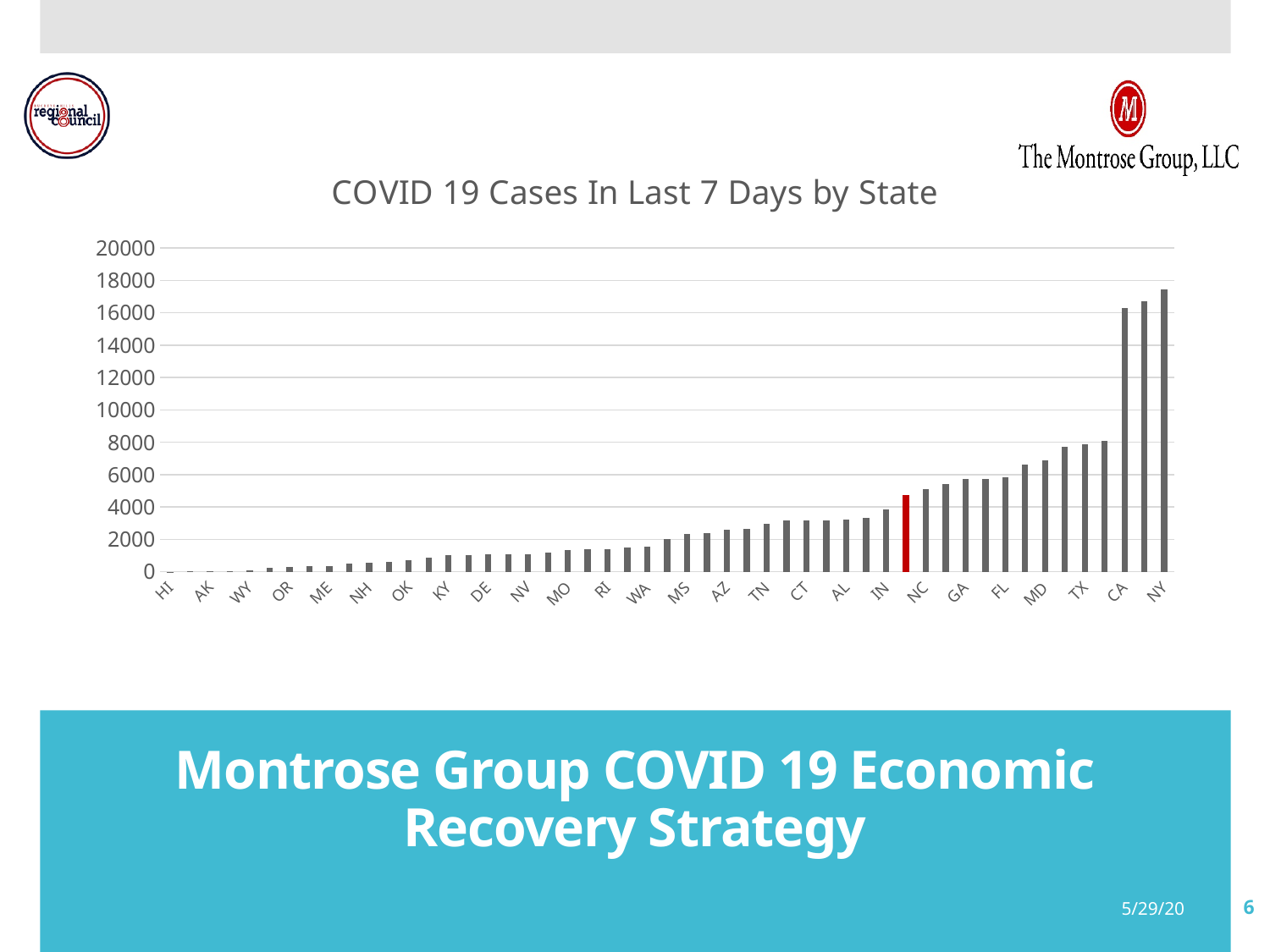
Which has more cases, TX or MD? TX Do the values rise or fall moving from left to right along the x axis? Rise What colour is the single highlighted bar that differs from the others? Red Is the value for CA greater or less than 14000? greater What is the title of the chart? COVID 19 Cases In Last 7 Days by State Which labeled state has the lowest number of COVID 19 cases in the last 7 days? HI Which state has the highest number of COVID 19 cases in the last 7 days? NY Which has more cases, NY or CA? NY What kind of chart is shown on the slide? Bar chart Is the value for WA greater or less than 2000? less Is the value for MD greater or less than 6000? greater